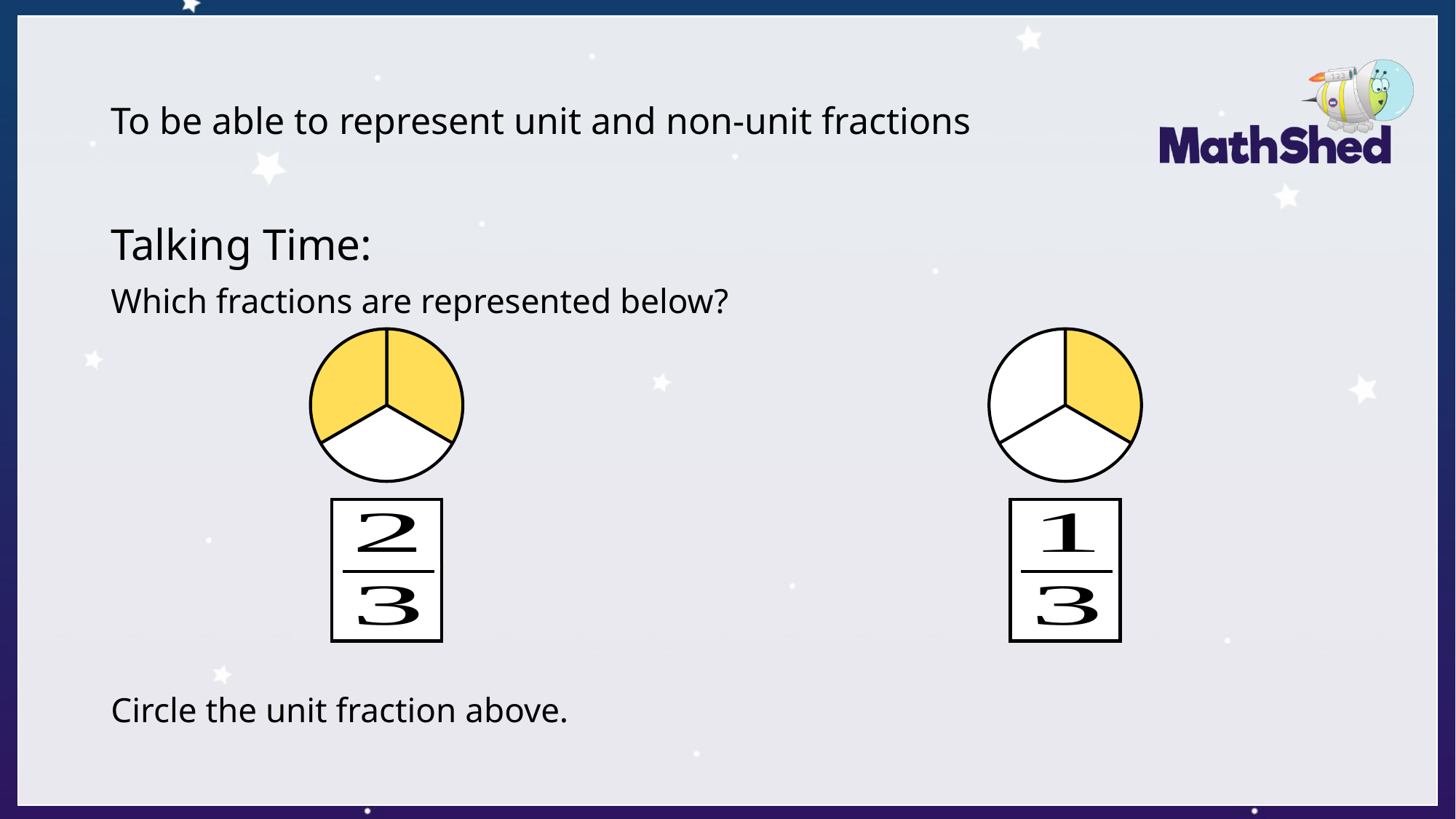
In the right circle, how many equal parts is the circle divided into? 3 In the left circle, how many parts are unshaded? 1 What fraction of the left circle is shaded? 2/3 What colour are the shaded parts of the circles? yellow Which circle has the larger shaded portion, the left or the right? left Which of the two fractions shown is the unit fraction? 1/3 What fraction of the right circle is shaded? 1/3 In the right circle, how many parts are shaded? 1 What kind of chart is used to represent the fractions on the slide? pie chart